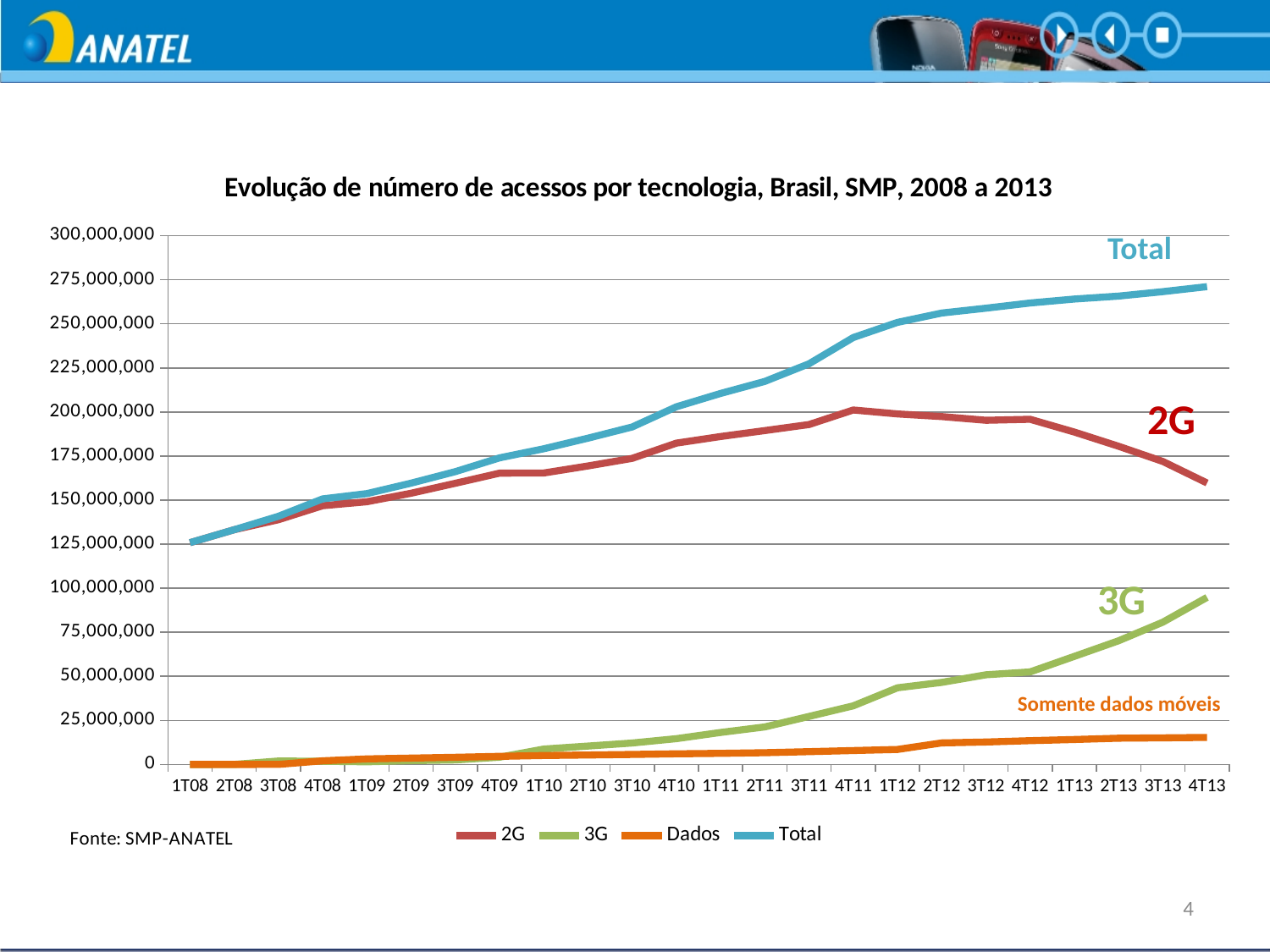
Is the value for Dados at 4T13 greater or less than 25,000,000? less How many series does the legend list? 4 How many quarters are plotted along the x axis? 24 What is the title of the chart? Evolução de número de acessos por tecnologia, Brasil, SMP, 2008 a 2013 What kind of chart is shown on the slide? line chart Is the value for Total at 4T13 greater or less than 250,000,000? greater Is the value for 3G at 4T13 greater or less than 100,000,000? less Does the 2G series rise or fall from 4T11 to 4T13? falls Does the Total series rise or fall from 1T08 to 4T13? rises At 4T13, which is larger, 3G or Dados? 3G